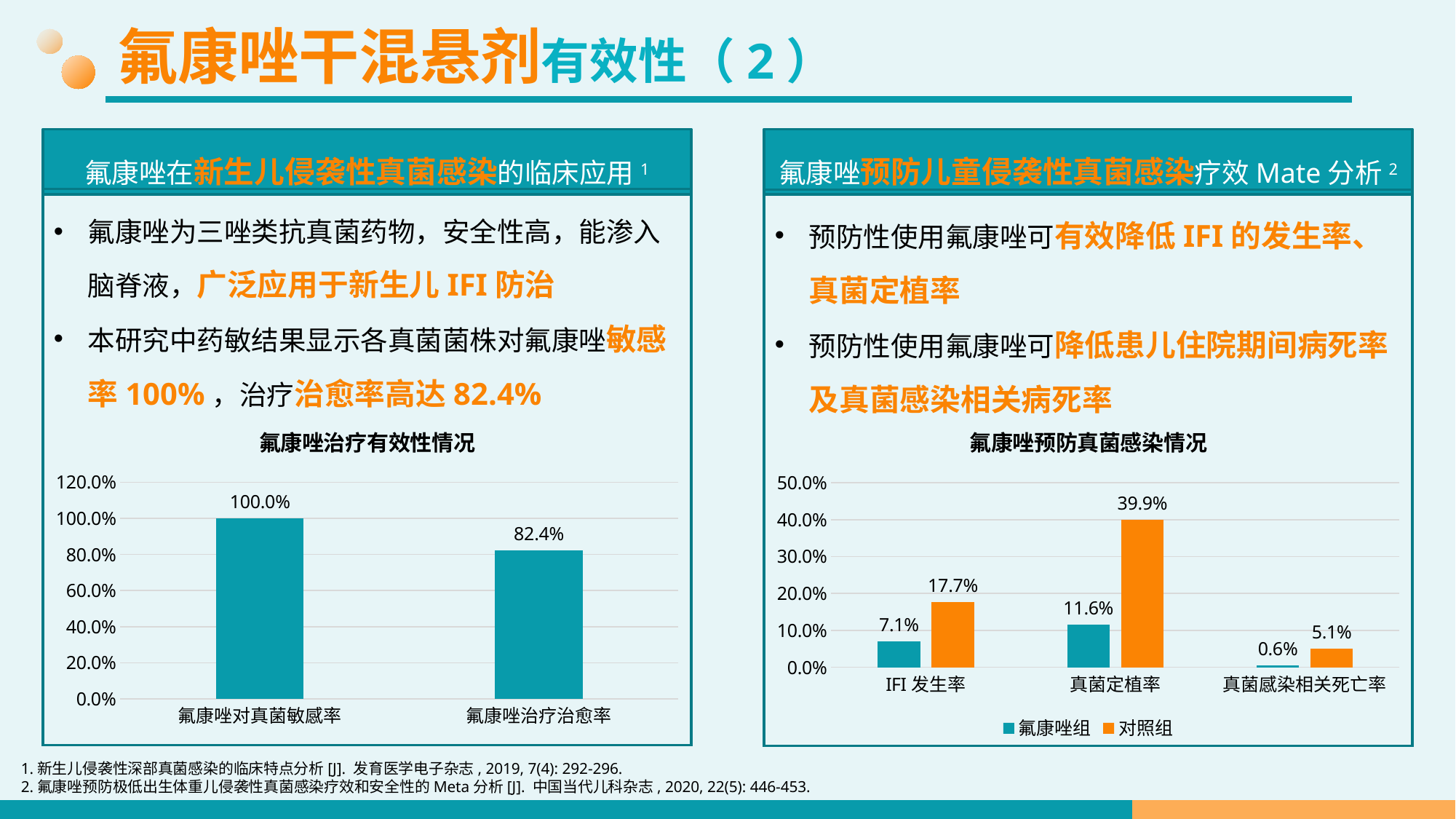
In the chart titled 氟康唑治疗有效性情况, what is the value for 氟康唑对真菌敏感率? 100.0% In the chart titled 氟康唑治疗有效性情况, how many categories are shown? 2 In the chart titled 氟康唑预防真菌感染情况, what is the value for 对照组 in 真菌定植率? 39.9% In the chart titled 氟康唑预防真菌感染情况, how many series does the legend list? 2 In the chart titled 氟康唑治疗有效性情况, what is the difference between 氟康唑对真菌敏感率 and 氟康唑治疗治愈率? 17.6% In the chart titled 氟康唑预防真菌感染情况, what is the value for 氟康唑组 in IFI 发生率? 7.1% In the chart titled 氟康唑预防真菌感染情况, which series is shown in orange? 对照组 What kind of chart is the chart titled 氟康唑治疗有效性情况? Bar chart In the chart titled 氟康唑预防真菌感染情况, which category has the highest value for 对照组? 真菌定植率 In the chart titled 氟康唑预防真菌感染情况, what is the difference between 对照组 and 氟康唑组 for IFI 发生率? 10.6% In the chart titled 氟康唑预防真菌感染情况, what is the value for 氟康唑组 in 真菌感染相关死亡率? 0.6% In the chart titled 氟康唑治疗有效性情况, what is the value for 氟康唑治疗治愈率? 82.4%